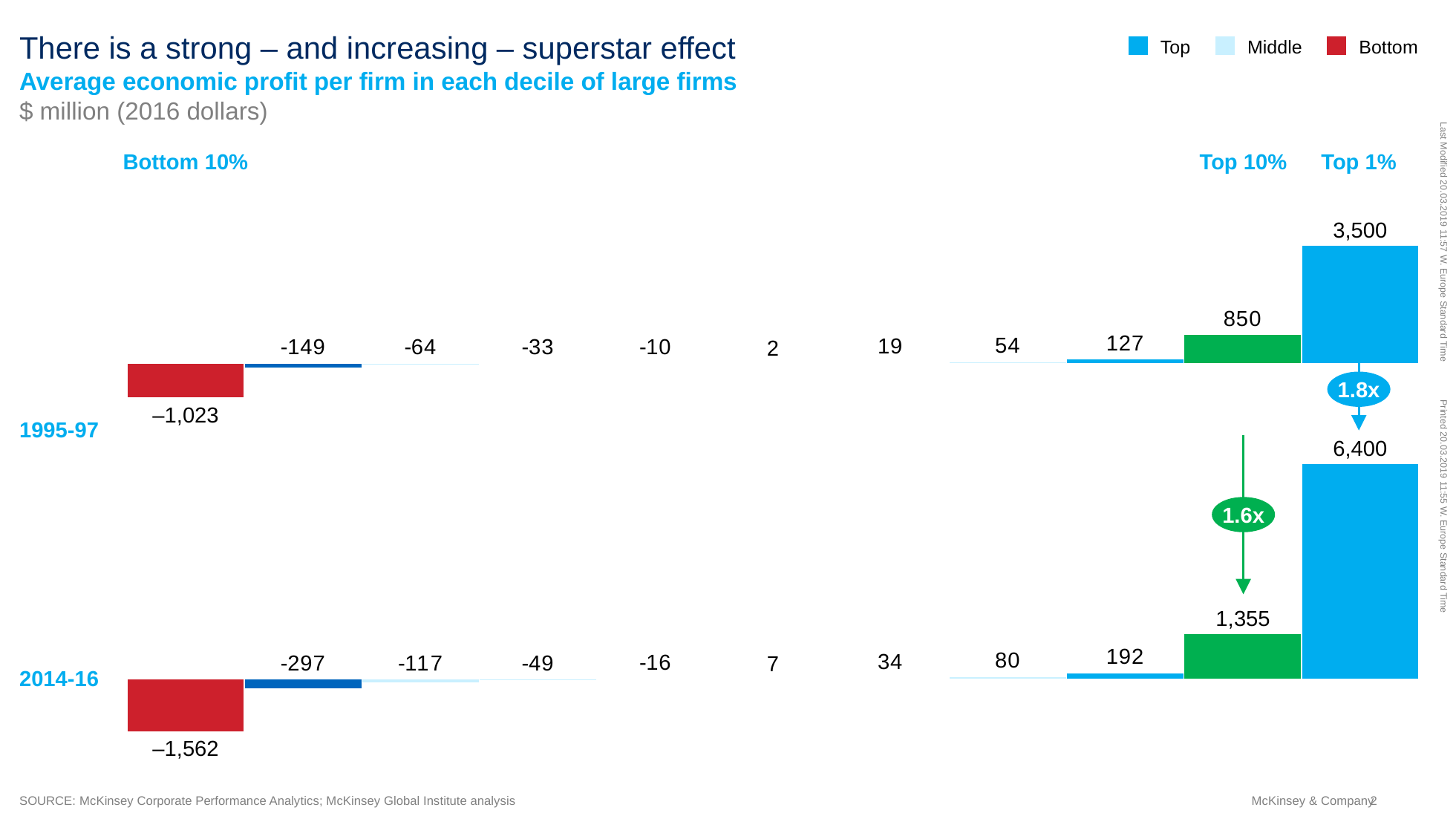
In the 2014-16 chart, what is the value for the Bottom 10%? –1,562 In the 1995-97 chart, what is the average economic profit per firm for the Top 1%? 3,500 In the 2014-16 chart, which group has the highest value? Top 1% What is the difference between the Top 10% value in 2014-16 and the Top 10% value in 1995-97? 505 In the 1995-97 chart, which group has the lowest value? Bottom 10% Which is larger: the Bottom 10% value in 1995-97 or the Bottom 10% value in 2014-16? 1995-97 In the 1995-97 chart, what is the value for the Top 10%? 850 In the 2014-16 chart, what is the value for the Top 10%? 1,355 What kind of chart is shown on the slide? Bar chart What is the difference between the Top 1% value in 2014-16 and the Top 1% value in 1995-97? 2,900 In the 2014-16 chart, what is the average economic profit per firm for the Top 1%? 6,400 How many series does the legend list? 3